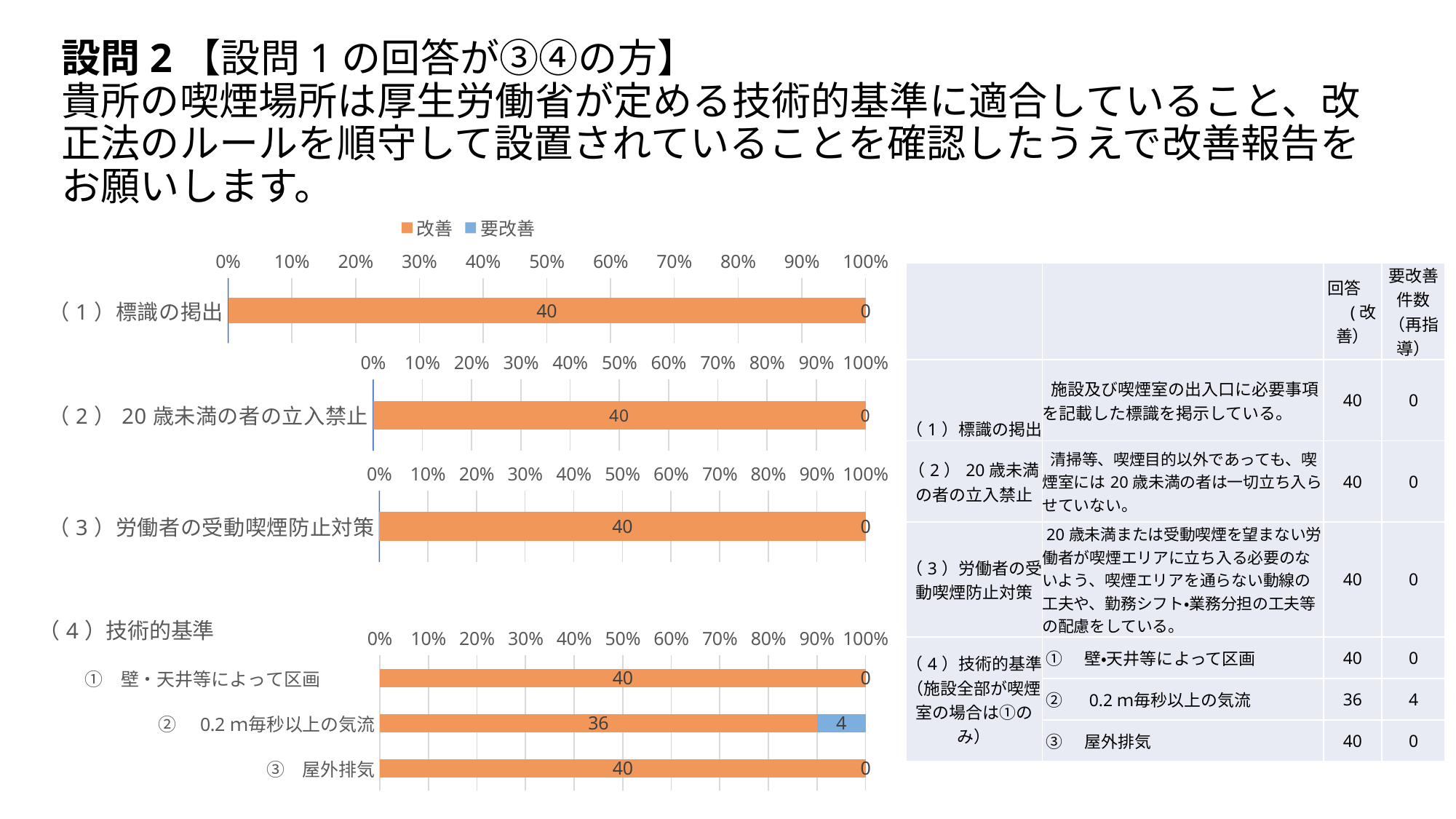
How many categories are plotted in the (4) 技術的基準 chart? 3 In the (4) 技術的基準 chart, what is the total of the 改善 and 要改善 values for ② 0.2 m毎秒以上の気流? 40 What type of chart is the (2) 20歳未満の者の立入禁止 chart? Bar chart In the (4) 技術的基準 chart, is the 改善 value for ② 0.2 m毎秒以上の気流 larger or smaller than its 要改善 value? larger In the (4) 技術的基準 chart, what is the 改善 value for ② 0.2 m毎秒以上の気流? 36 In the (4) 技術的基準 chart, which category has the highest 要改善 value? ② 0.2 m毎秒以上の気流 How many series does the legend list for the charts? 2 In the (1) 標識の掲出 chart, what is the 改善 value? 40 In the (4) 技術的基準 chart, what is the difference between the 改善 values for ① 壁・天井等によって区画 and ② 0.2 m毎秒以上の気流? 4 In the (3) 労働者の受動喫煙防止対策 chart, what is the 要改善 value? 0 In the (4) 技術的基準 chart, what is the 要改善 value for ② 0.2 m毎秒以上の気流? 4 In the (4) 技術的基準 chart, which category has the lowest 改善 value? ② 0.2 m毎秒以上の気流